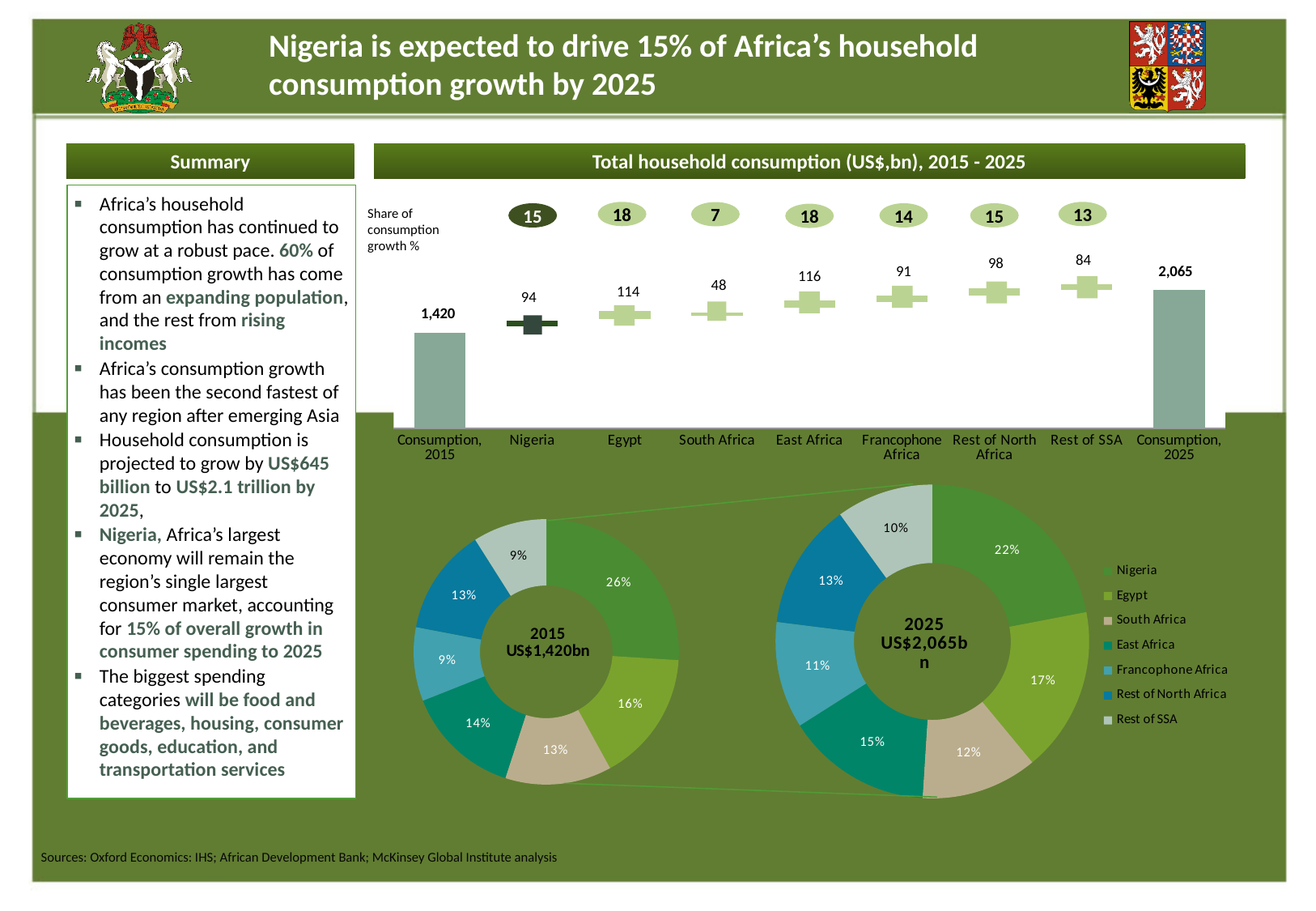
In the 'Total household consumption (US$,bn), 2015 - 2025' chart, what is the value for Egypt? 114 In the 'Total household consumption (US$,bn), 2015 - 2025' chart, which country or region contributes the largest increment? East Africa In the 'Total household consumption (US$,bn), 2015 - 2025' chart, which is larger, the increment for Rest of North Africa or for Rest of SSA? Rest of North Africa In the 'Total household consumption (US$,bn), 2015 - 2025' chart, what share of consumption growth % is shown for Nigeria? 15 In the 'Total household consumption (US$,bn), 2015 - 2025' chart, what is the difference between Consumption, 2025 and Consumption, 2015? 645 In the 'Total household consumption (US$,bn), 2015 - 2025' chart, what is the value for Consumption, 2015? 1,420 What kind of chart is used to show the 2015 and 2025 consumption shares by region? Donut chart In the 'Total household consumption (US$,bn), 2015 - 2025' chart, what is the value for Consumption, 2025? 2,065 In the 'Total household consumption (US$,bn), 2015 - 2025' chart, which country or region contributes the smallest increment? South Africa How many entries does the legend of the donut charts list? 7 In the 2025 US$2,065bn donut chart, what share does Egypt hold? 17% In the 2015 US$1,420bn donut chart, what share does Nigeria hold? 26%